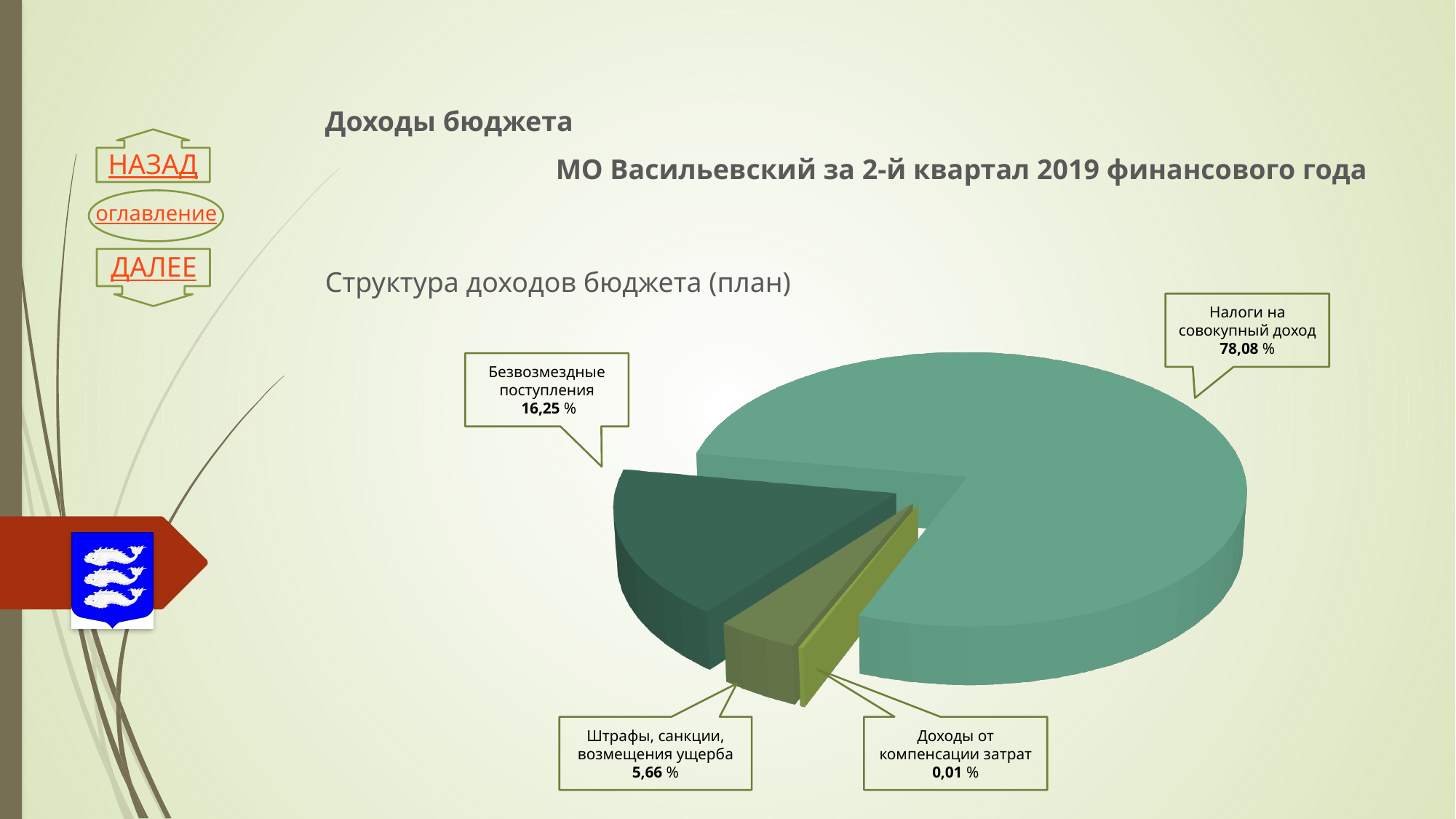
Which is larger: the share of "Безвозмездные поступления" or the share of "Штрафы, санкции, возмещения ущерба"? Безвозмездные поступления What is the value shown for "Доходы от компенсации затрат"? 0,01 % What is the difference between the shares of "Налоги на совокупный доход" and "Безвозмездные поступления"? 61,83 % What share of the pie does "Налоги на совокупный доход" have? 78,08 % What is the title of the chart? Структура доходов бюджета (план) How many slices does the pie chart have? 4 Which category has the smallest share of the pie? Доходы от компенсации затрат What type of chart is shown on the slide? Pie chart What is the value shown for "Штрафы, санкции, возмещения ущерба"? 5,66 % What is the value shown for "Безвозмездные поступления"? 16,25 % What is the difference between the shares of "Штрафы, санкции, возмещения ущерба" and "Доходы от компенсации затрат"? 5,65 % Which category has the largest share of the pie? Налоги на совокупный доход